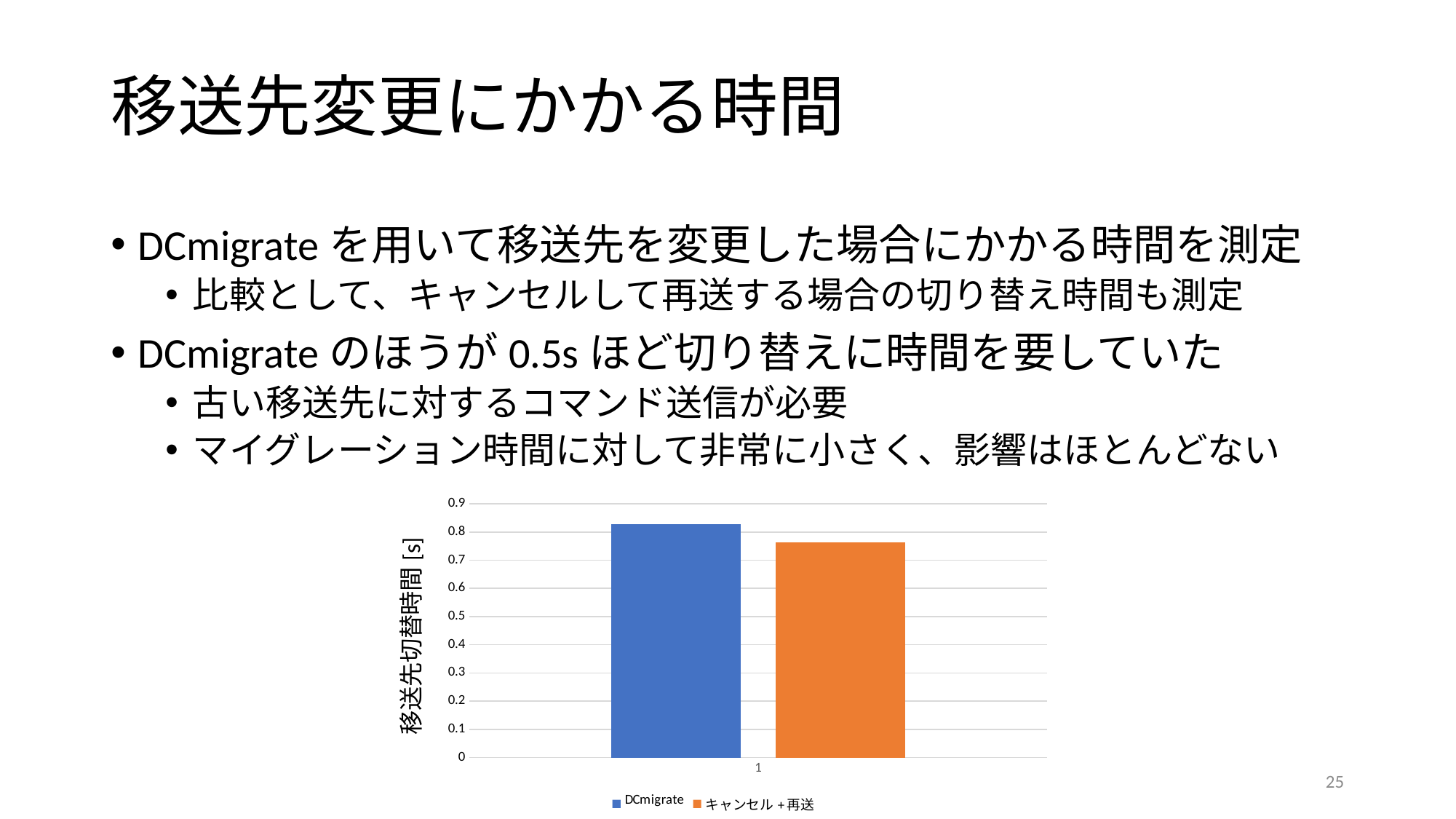
Which series has the lowest value in the chart? キャンセル + 再送 How many series does the chart legend list? 2 How many categories are shown on the x axis of the chart? 1 Is the value for DCmigrate greater or less than 0.9? less Which series has the highest value in the chart? DCmigrate What kind of chart is shown on the slide? bar chart Which series has the taller bar, DCmigrate or キャンセル + 再送? DCmigrate Is the value for キャンセル + 再送 greater or less than 0.5? greater What colour is the bar for キャンセル + 再送? orange What is the label of the chart's vertical axis? 移送先切替時間 [s] Is the value for DCmigrate greater or less than 0.8? greater